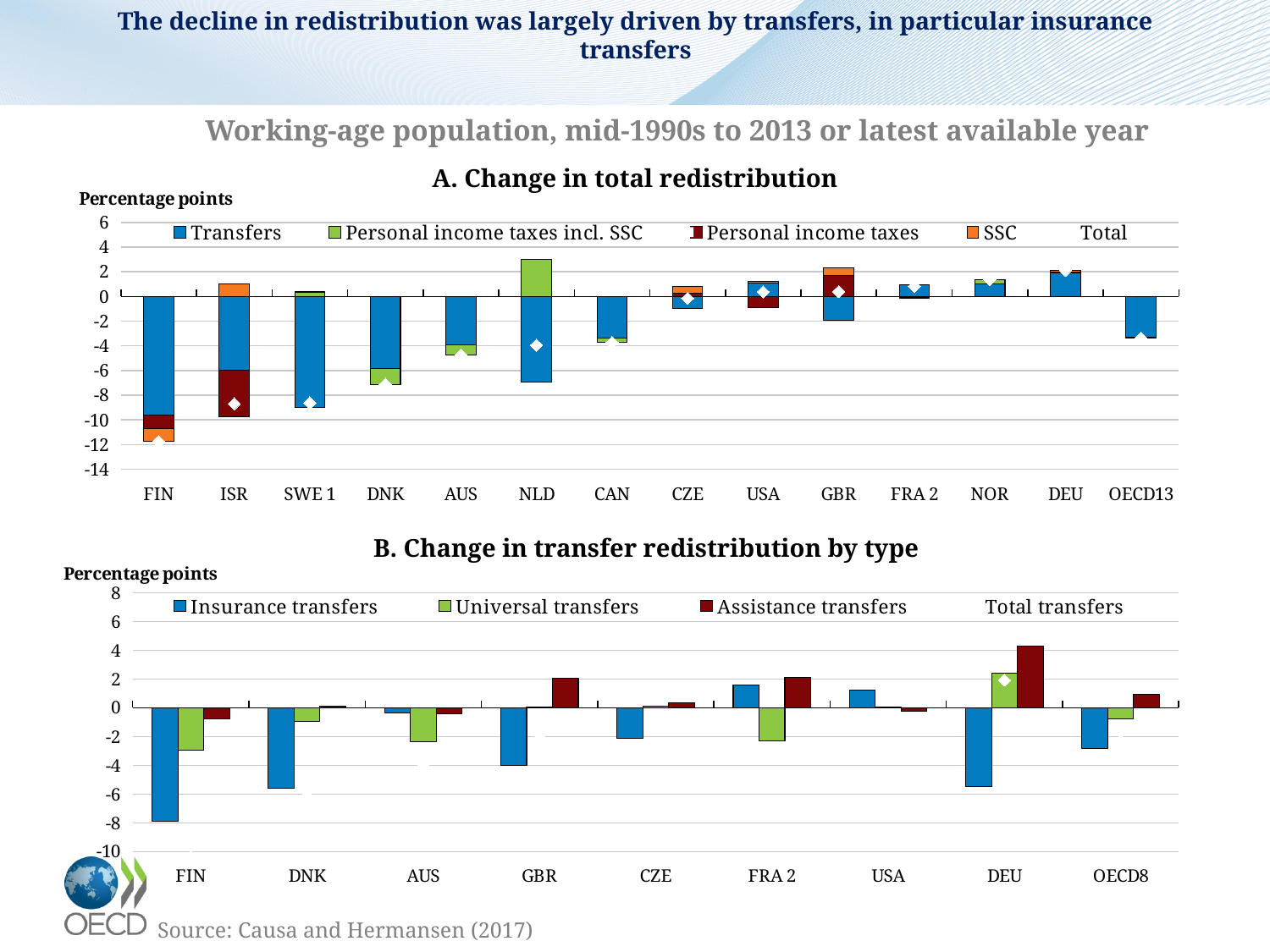
What kind of chart is chart B, "Change in transfer redistribution by type"? bar chart In chart A, "Change in total redistribution", which category has the highest value for Personal income taxes incl. SSC? NLD In chart B, "Change in transfer redistribution by type", which category has the highest value for Assistance transfers? DEU In chart B, "Change in transfer redistribution by type", which category has the lowest value for Insurance transfers? FIN What is the y-axis label of chart B, "Change in transfer redistribution by type"? Percentage points In chart B, "Change in transfer redistribution by type", is the value of Assistance transfers for DEU greater or less than 2? greater In chart A, "Change in total redistribution", is the value of Transfers for NLD greater or less than -4? less How many categories are shown on the x axis of chart A, "Change in total redistribution"? 14 How many series does the legend of chart B, "Change in transfer redistribution by type", list? 4 How many series does the legend of chart A, "Change in total redistribution", list? 5 In chart B, "Change in transfer redistribution by type", is the value of Insurance transfers for FIN greater or less than -6? less In chart B, "Change in transfer redistribution by type", which is larger, the Insurance transfers value for FIN or for USA? USA